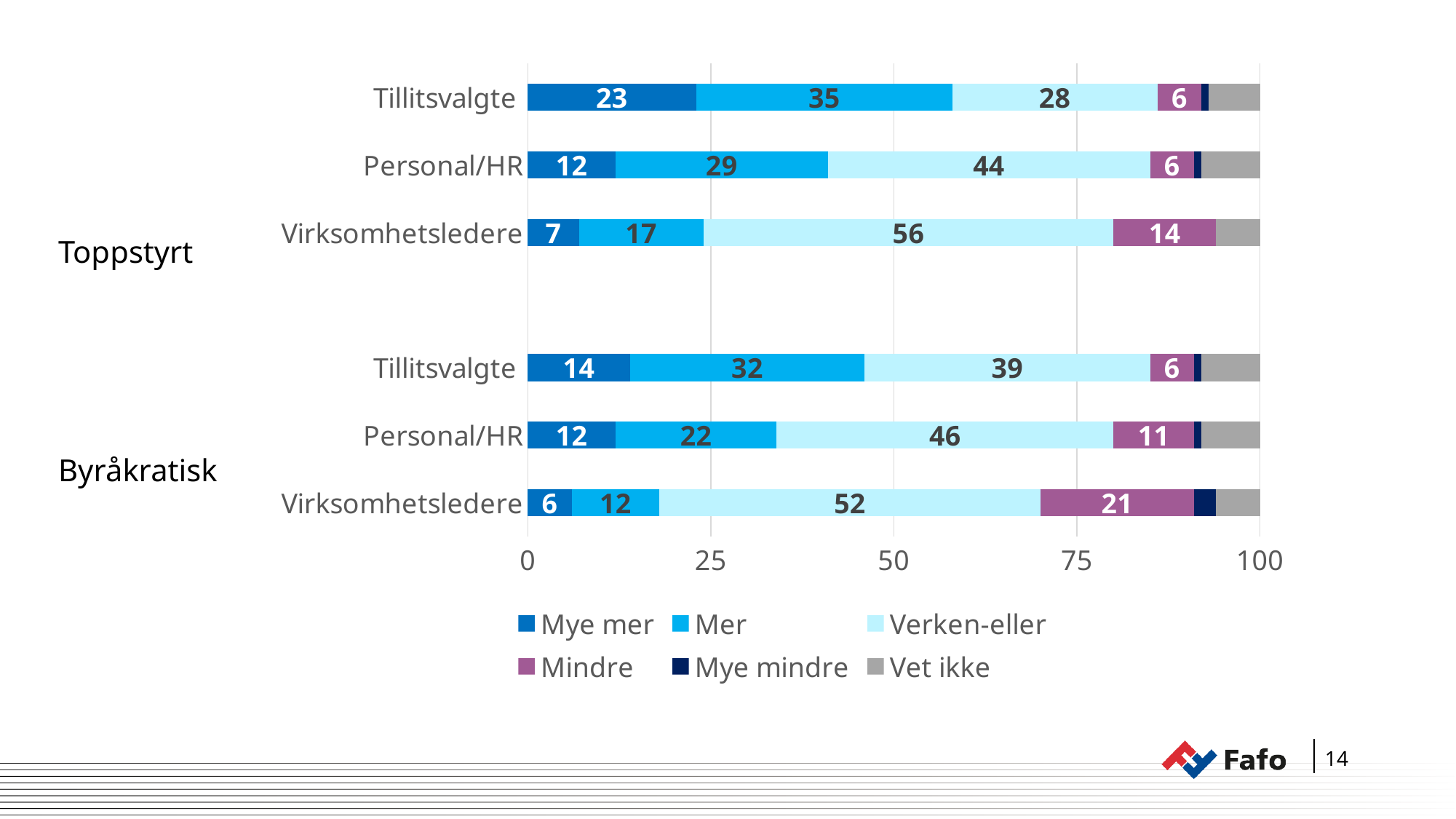
Is the combined "Mye mer" and "Mer" portion for Tillitsvalgte in the Toppstyrt group greater or less than 50? greater Which legend entry is shown in purple? Mindre What kind of chart is shown on the slide? Stacked bar chart What is the value of the "Mindre" segment for Virksomhetsledere in the Byråkratisk group? 21 How many series does the legend list? 6 What is the value of the "Verken-eller" segment for Virksomhetsledere in the Toppstyrt group? 56 What is the value of the "Mye mer" segment for Personal/HR in the Byråkratisk group? 12 Which bar has the highest "Mye mer" value? Tillitsvalgte (Toppstyrt) Which bar has the lowest "Mye mer" value? Virksomhetsledere (Byråkratisk) What is the value of the "Mer" segment for Tillitsvalgte in the Toppstyrt group? 35 What is the difference between the "Verken-eller" values for Personal/HR in the Byråkratisk group and Personal/HR in the Toppstyrt group? 2 Which is larger: the "Mer" value for Tillitsvalgte in the Toppstyrt group or the "Mer" value for Tillitsvalgte in the Byråkratisk group? Tillitsvalgte (Toppstyrt)